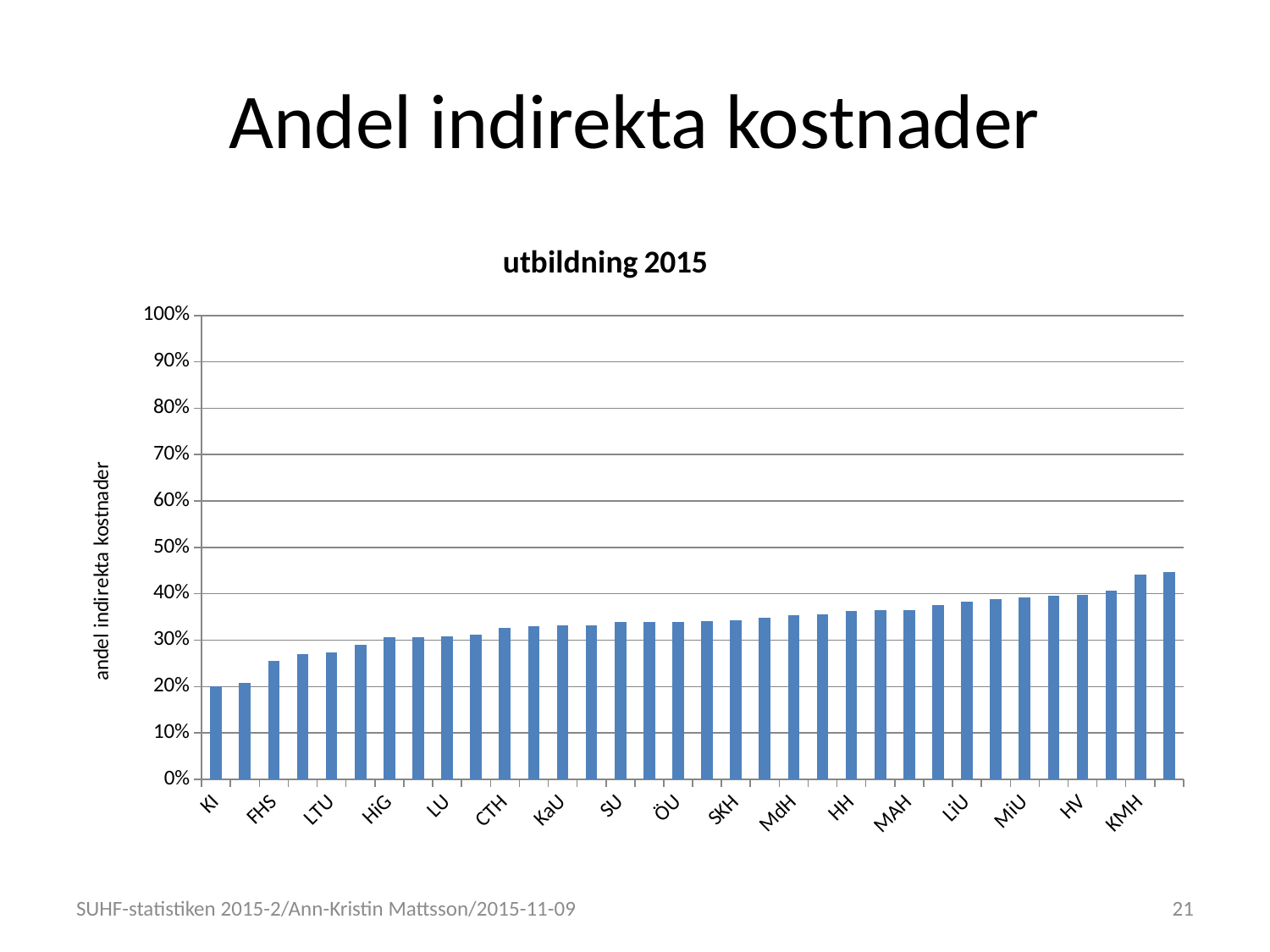
What kind of chart is shown on the slide? bar chart Is the value for MdH greater or less than 40%? less Which has the larger value, FHS or HV? HV Is the value for LiU greater or less than 40%? less What is the title of the chart? utbildning 2015 Is the value for LTU greater or less than 30%? less Which has the larger value, KI or KMH? KMH Do the bar values rise or fall from left to right along the x axis? rise What is the label on the vertical axis of the chart? andel indirekta kostnader